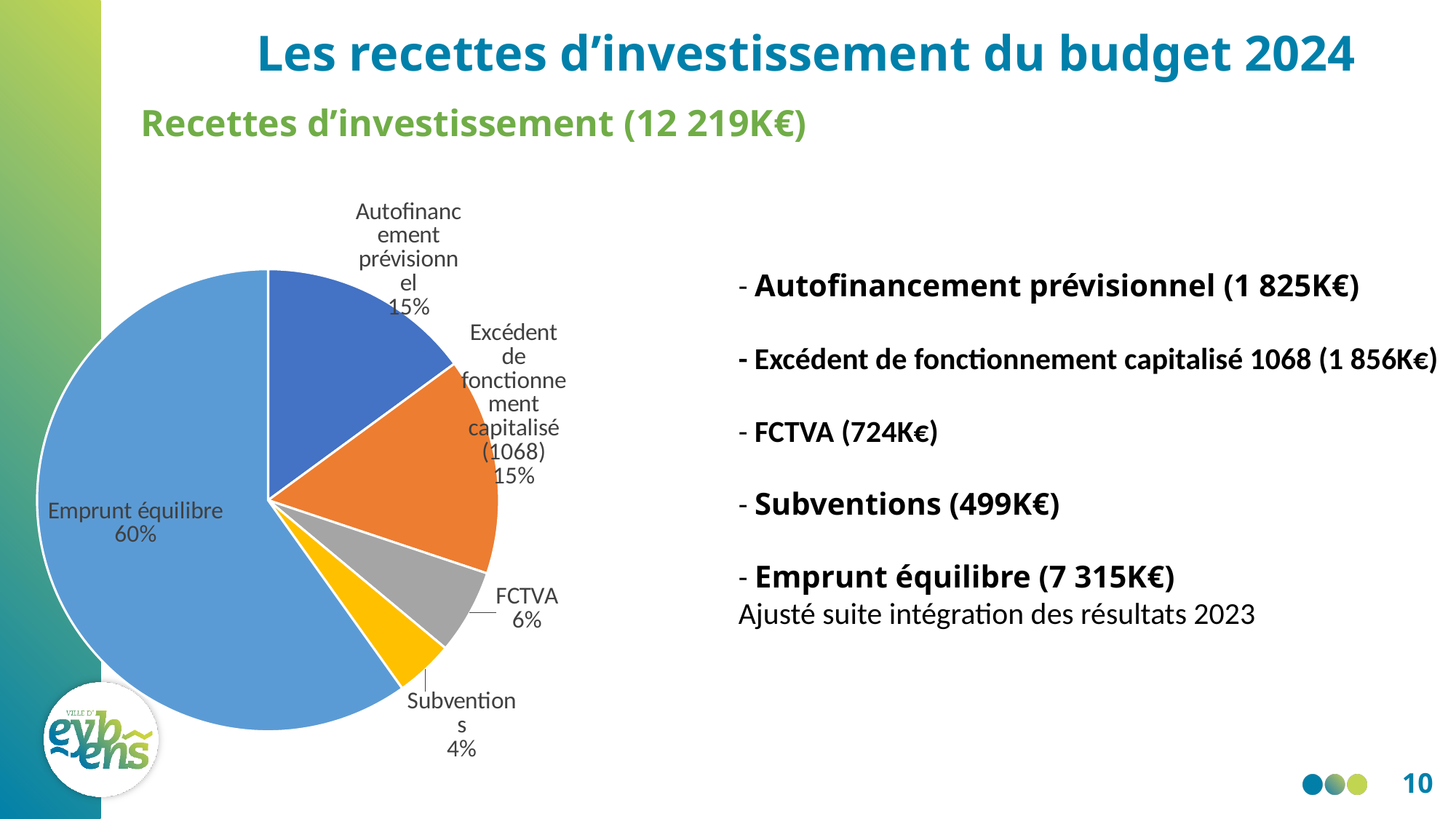
What share of the pie does Autofinancement prévisionnel represent? 15% Which slice of the pie is the largest? Emprunt équilibre What colour is the Subventions slice? yellow Which slice of the pie is the smallest? Subventions What total amount is given in the green subtitle above the chart? 12 219K€ Which is larger, the FCTVA slice or the Subventions slice? FCTVA What is the difference in percentage points between the Emprunt équilibre slice and the Autofinancement prévisionnel slice? 45 How many slices does the pie chart have? 5 What share of the pie does Emprunt équilibre represent? 60% What kind of chart is shown on the slide? pie chart What share of the pie does Subventions represent? 4%